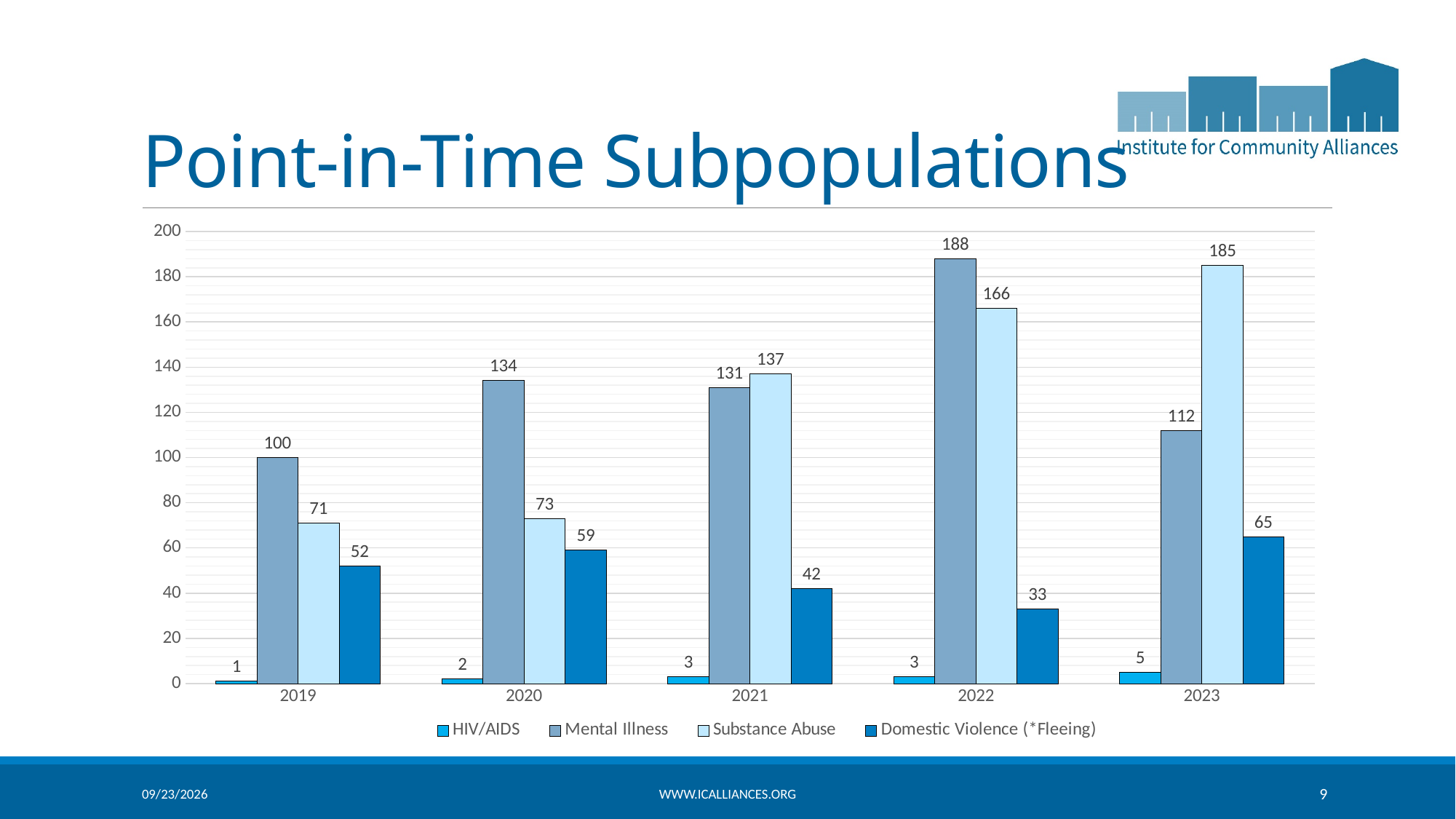
How many years are shown on the x axis? 5 Does the HIV/AIDS value rise or fall from 2019 to 2023? Rise What is the value for Substance Abuse in 2023? 185 How many series does the legend list? 4 What is the difference between the Substance Abuse values in 2023 and 2022? 19 What kind of chart is shown on the slide? Bar chart What is the value for Mental Illness in 2022? 188 Which is larger in 2021: Mental Illness or Substance Abuse? Substance Abuse In which year is the Mental Illness value highest? 2022 What is the value for Domestic Violence (*Fleeing) in 2019? 52 What is the value for HIV/AIDS in 2023? 5 In which year is the Domestic Violence (*Fleeing) value lowest? 2022